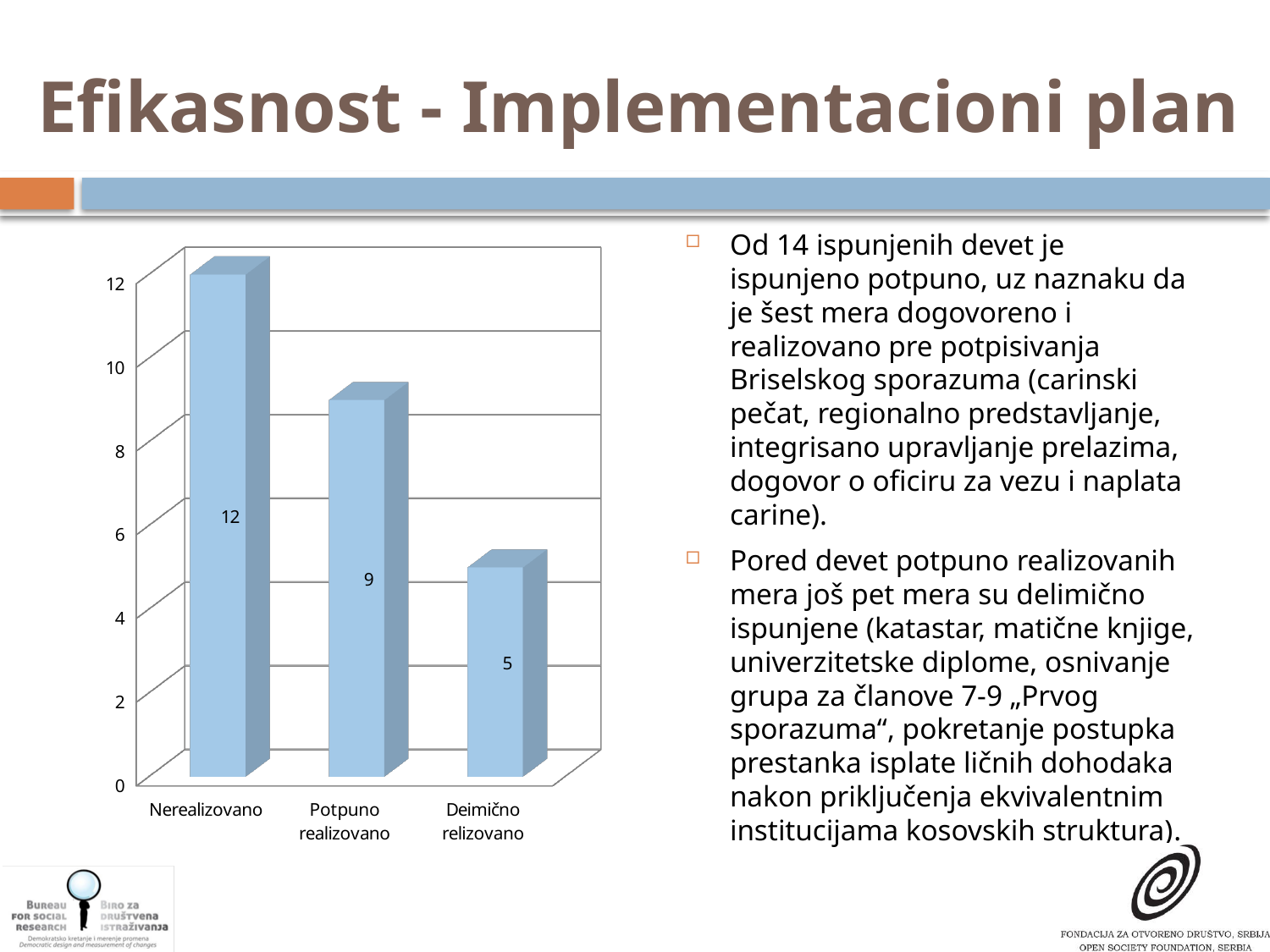
Which category has the highest value? Nerealizovano How many categories are shown on the chart? 3 What is the difference between the values for Nerealizovano and Potpuno realizovano? 3 What is the value for Potpuno realizovano? 9 What is the value for Nerealizovano? 12 What is the difference between the values for Potpuno realizovano and Deimično relizovano? 4 Which is larger, the value for Potpuno realizovano or the value for Deimično relizovano? Potpuno realizovano Which category has the lowest value? Deimično relizovano Is the value for Potpuno realizovano greater or less than 8? greater Do the values rise or fall from left to right across the categories? fall What is the value for Deimično relizovano? 5 What kind of chart is shown on the slide? bar chart